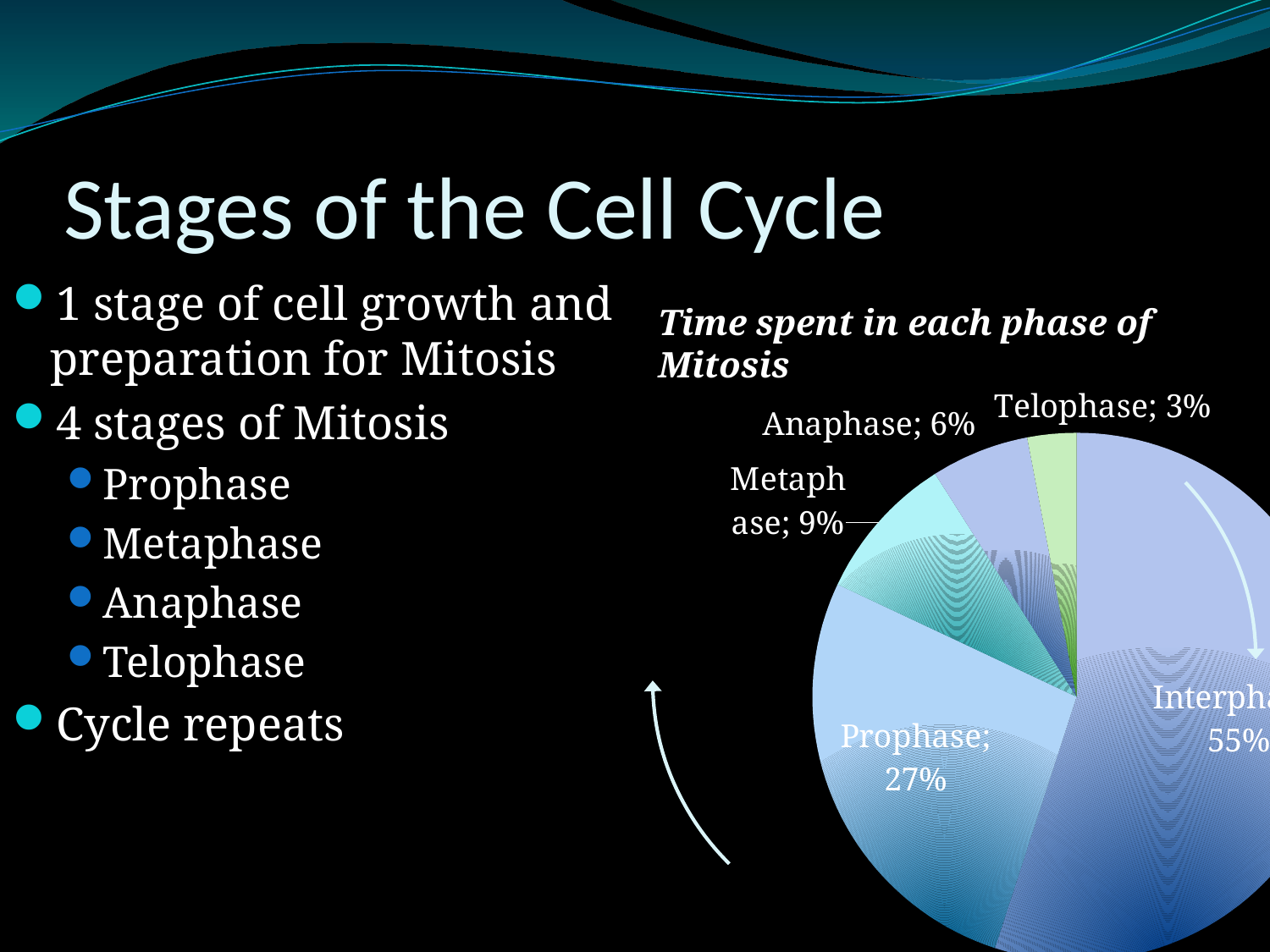
How many percentage points larger is the Prophase slice than the Metaphase slice? 18% What is the chart's title? Time spent in each phase of Mitosis Which slice is larger, Anaphase or Telophase? Anaphase What is the percentage shown for the largest slice of the pie chart? 55% What percentage of time is spent in Anaphase according to the pie chart? 6% Which phase has the smallest slice in the pie chart? Telophase What kind of chart is shown on the slide? pie chart How many slices does the pie chart have? 5 Which phase has the largest slice in the pie chart? Interphase What percentage of time is spent in Telophase according to the pie chart? 3% What percentage of time is spent in Metaphase according to the pie chart? 9% What percentage of time is spent in Prophase according to the pie chart? 27%